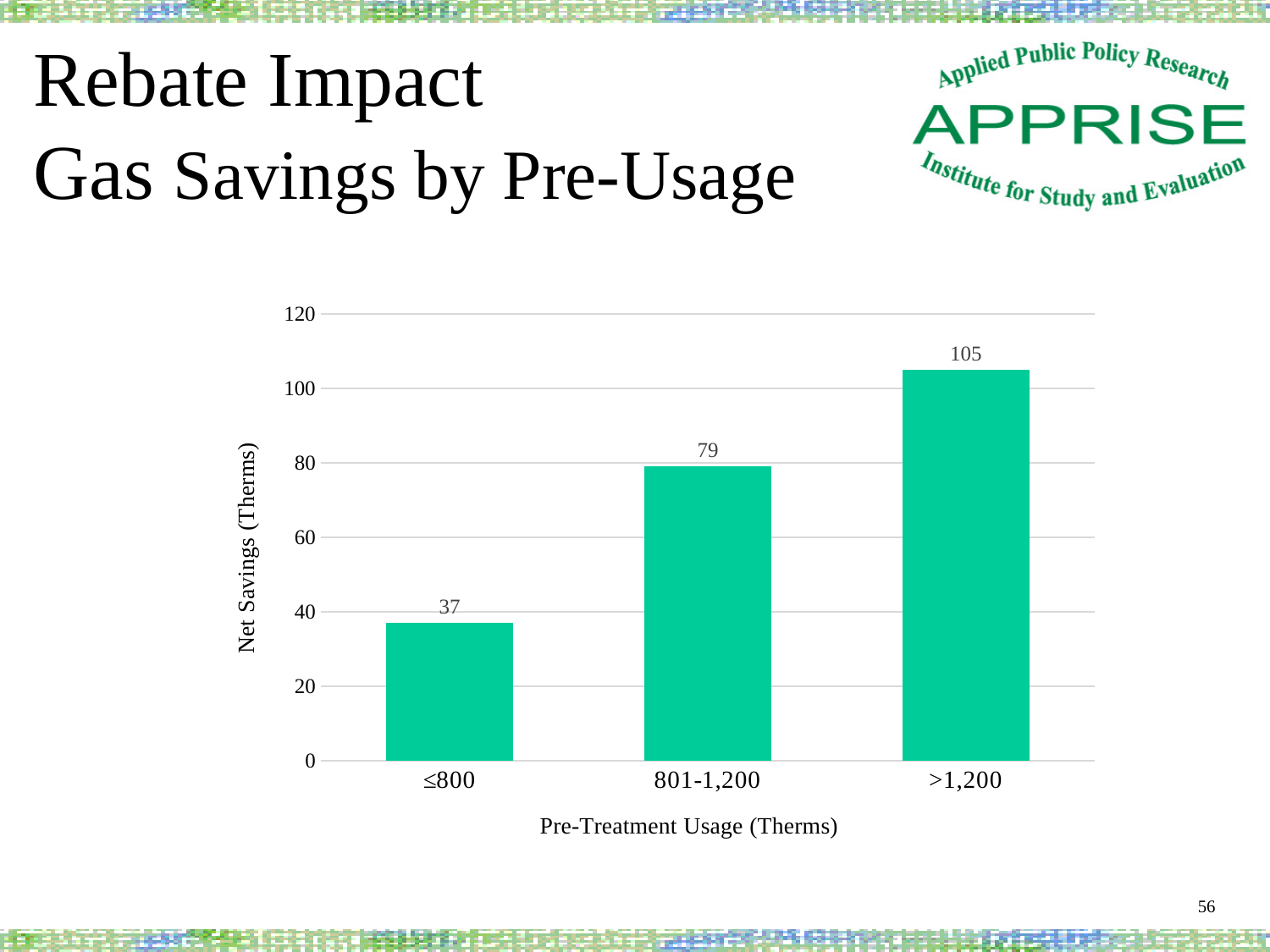
Which pre-treatment usage group has the highest net savings? >1,200 What is the net savings value for the 801-1,200 pre-treatment usage group? 79 What is the net savings value for the ≤800 pre-treatment usage group? 37 How many pre-treatment usage categories are shown on the chart? 3 What is the net savings value for the >1,200 pre-treatment usage group? 105 Do net savings rise or fall as pre-treatment usage increases along the x axis? rise Is the net savings value for the 801-1,200 group greater or less than 100? less What is the difference in net savings between the 801-1,200 group and the ≤800 group? 42 What is the difference in net savings between the >1,200 group and the ≤800 group? 68 What kind of chart is shown on the slide? bar chart Which has larger net savings, the 801-1,200 group or the >1,200 group? >1,200 Which pre-treatment usage group has the lowest net savings? ≤800